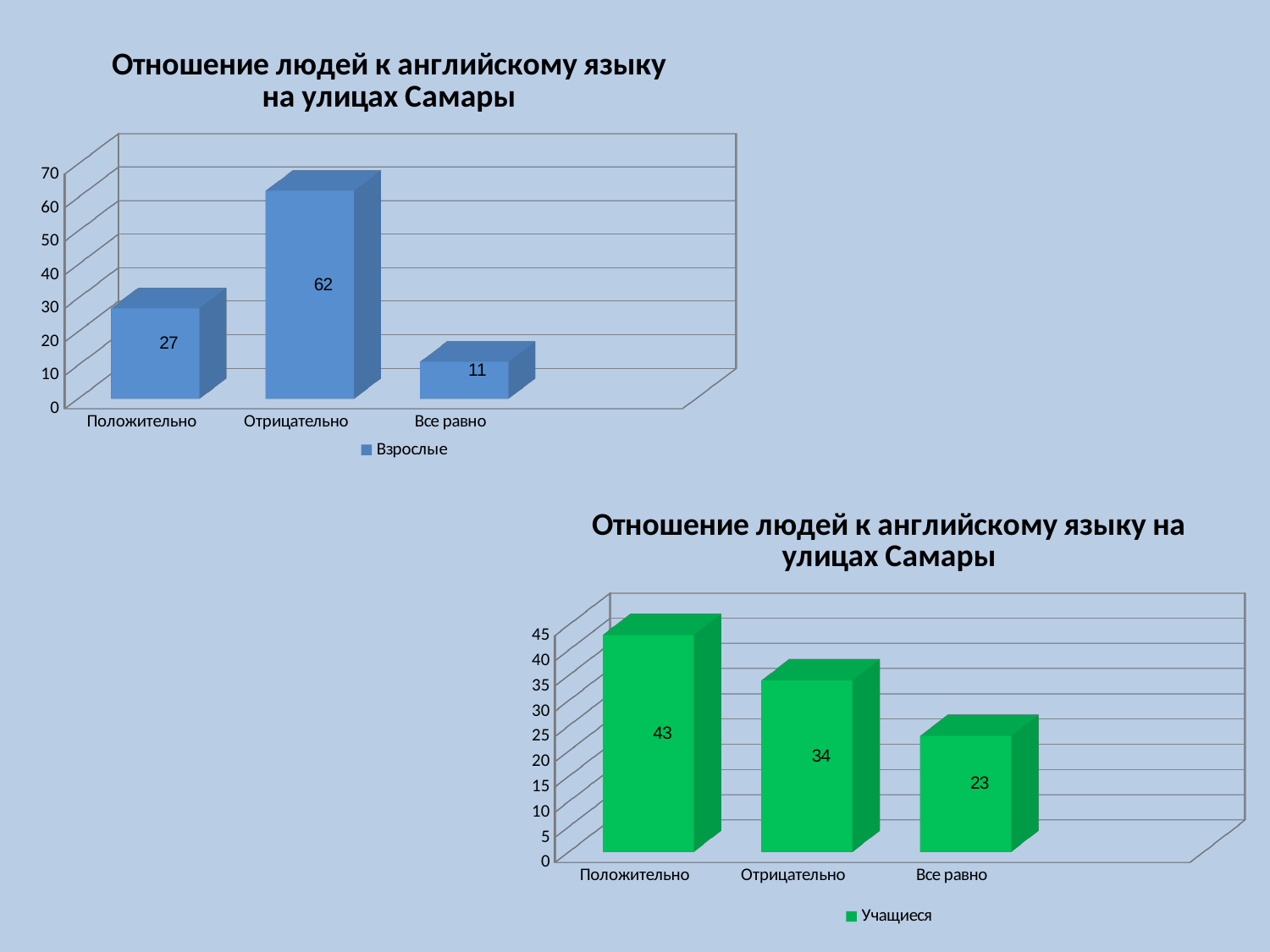
In the bottom-right chart (Учащиеся), which category has the highest value? Положительно In the bottom-right chart (Учащиеся), what is the value for Все равно? 23 In the top-left chart (Взрослые), what is the value for Отрицательно? 62 How many series does the legend of the bottom-right chart list? 1 What is the legend entry of the top-left chart? Взрослые In the bottom-right chart (Учащиеся), which is larger: the value for Отрицательно or the value for Все равно? Отрицательно In the bottom-right chart (Учащиеся), what is the difference between the values for Положительно and Отрицательно? 9 In the top-left chart (Взрослые), which category has the lowest value? Все равно In the top-left chart (Взрослые), what is the value for Положительно? 27 How many categories are shown in the top-left chart (Взрослые)? 3 In the top-left chart (Взрослые), what is the difference between the values for Отрицательно and Положительно? 35 What kind of chart is the bottom-right chart (Учащиеся)? Bar chart